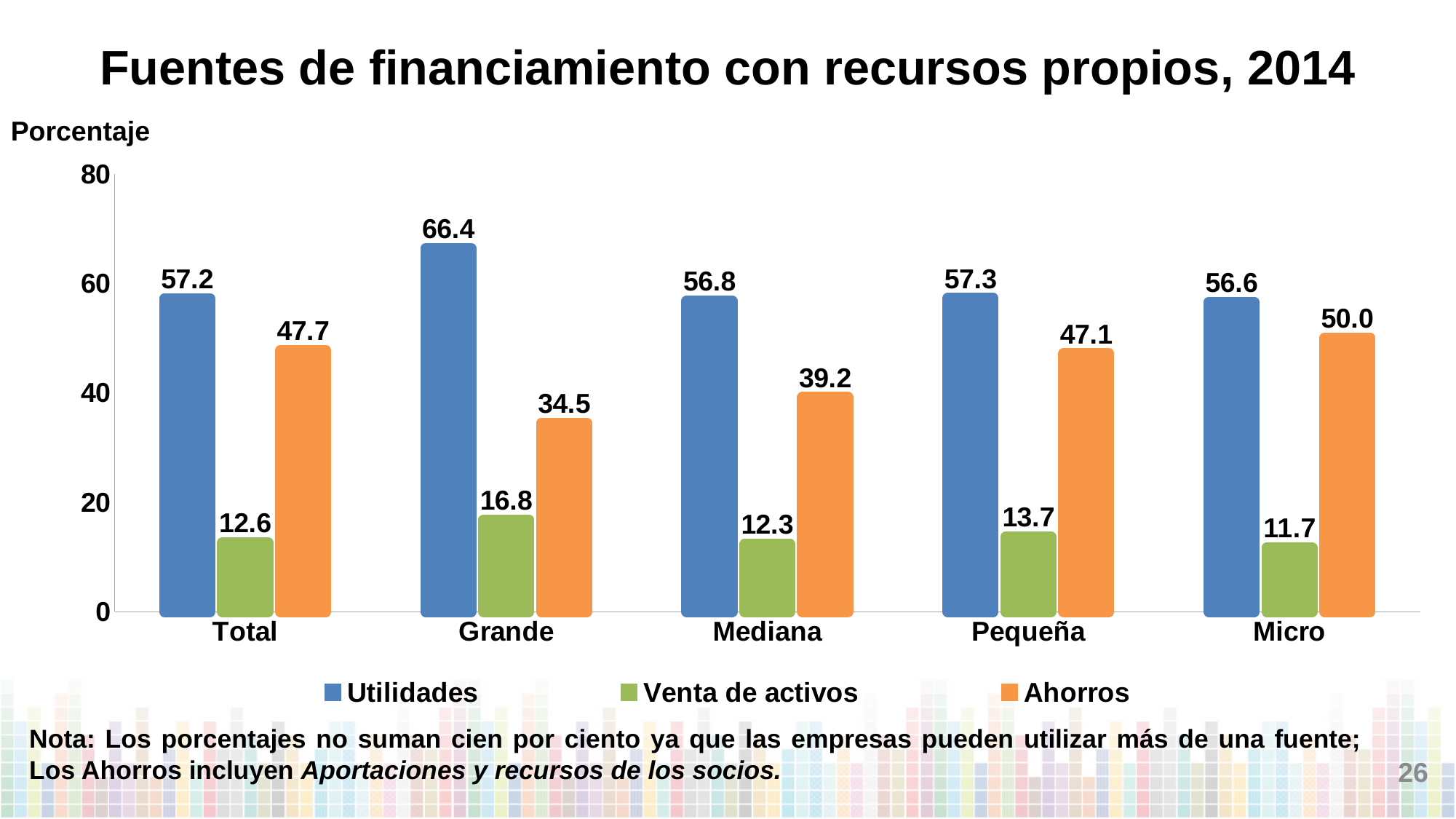
Which is larger for Pequeña: Utilidades or Ahorros? Utilidades What is the difference between Utilidades and Ahorros for Grande? 31.9 Which category has the lowest value for Ahorros? Grande How many categories are shown on the x axis? 5 Which category has the highest value for Utilidades? Grande Which category has the lowest value for Venta de activos? Micro What is the value of Utilidades for Grande? 66.4 What is the value of Venta de activos for Mediana? 12.3 What is the value of Ahorros for Micro? 50.0 What kind of chart is shown on the slide? Bar chart How many series does the legend list? 3 Is the value of Ahorros for Mediana greater or less than 40? less